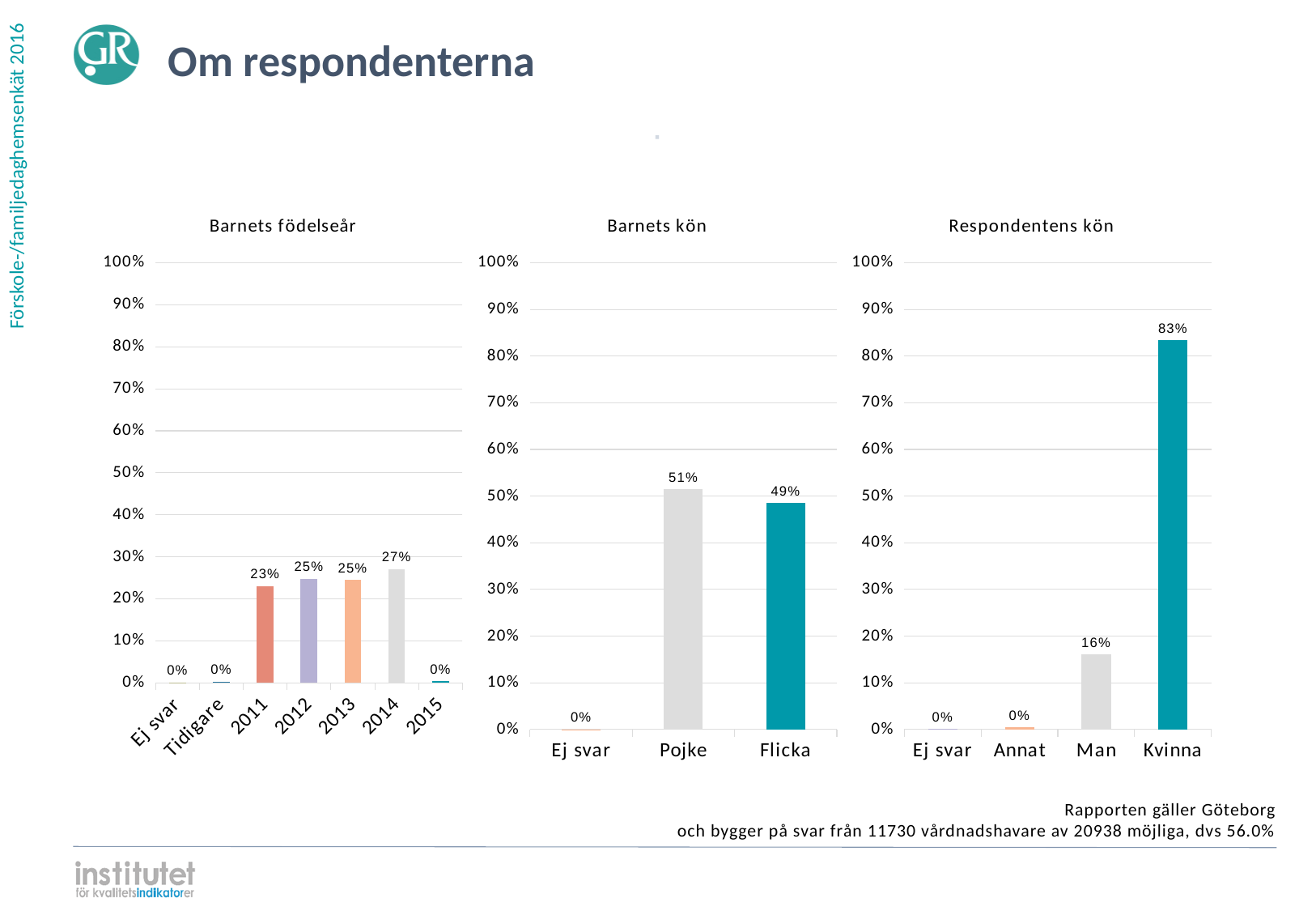
In the 'Respondentens kön' chart, which category has the highest value? Kvinna What kind of chart is the 'Barnets kön' chart? Bar chart In the 'Barnets kön' chart, which is larger, Pojke or Flicka? Pojke In the 'Respondentens kön' chart, what is the value for Kvinna? 83% In the 'Barnets kön' chart, what is the value for Pojke? 51% In the 'Respondentens kön' chart, what is the value for Man? 16% In the 'Barnets födelseår' chart, what is the value for 2014? 27% In the 'Barnets födelseår' chart, how many categories are shown on the x axis? 7 In the 'Barnets födelseår' chart, what is the difference between the values for 2014 and 2011? 4% In the 'Barnets födelseår' chart, which category has the highest value? 2014 In the 'Barnets kön' chart, what is the difference between Pojke and Flicka? 2% In the 'Respondentens kön' chart, what is the difference between Kvinna and Man? 67%